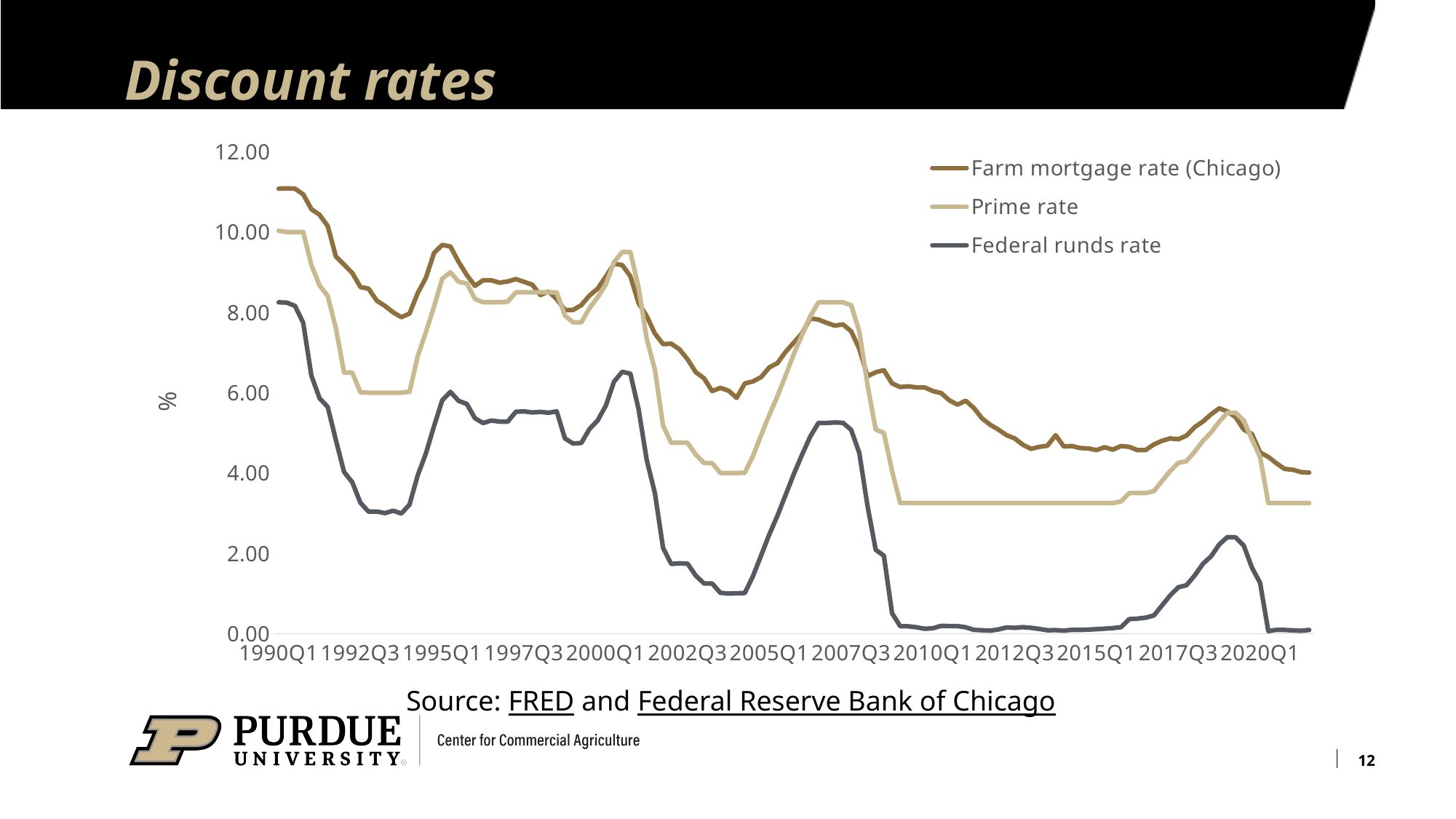
At 1990Q1, which is higher: the Farm mortgage rate (Chicago) or the Federal funds rate? Farm mortgage rate (Chicago) What kind of chart is shown on the slide? Line chart Is the Federal funds rate at 1990Q1 greater or less than 6.00? greater Does the Farm mortgage rate (Chicago) overall rise or fall from 1990Q1 to 2020Q1? Fall At 2012Q3, which is higher: the Prime rate or the Federal funds rate? Prime rate What is the label on the y axis? % Is the Farm mortgage rate (Chicago) at 1990Q1 greater or less than 10.00? greater Which series has the lowest value at 2012Q3? Federal funds rate Is the Prime rate at 2012Q3 greater or less than 4.00? less What are the three series named in the legend? Farm mortgage rate (Chicago), Prime rate, Federal runds rate How many series does the legend list? 3